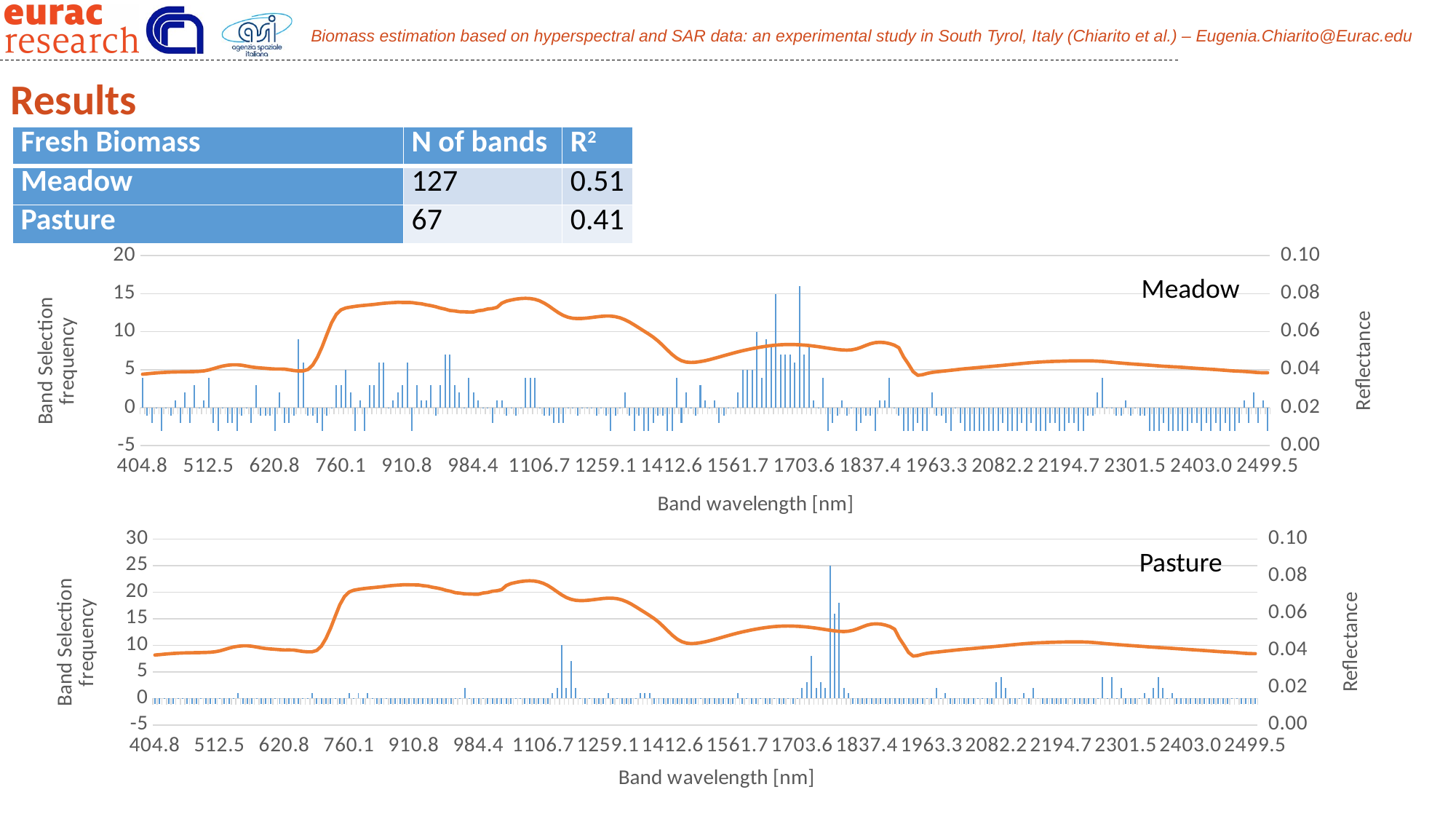
How many wavelength labels are shown along the x axis of the Meadow chart? 18 Which chart, Meadow or Pasture, has the higher maximum band selection frequency? Pasture How many charts are shown on the slide? 2 In the Meadow chart, is the highest band selection frequency bar greater or less than 10? greater What kind of chart is the Meadow chart? Combined bar and line chart What is the title of the right-hand vertical axis on the Meadow chart? Reflectance What is the x-axis title of the Pasture chart? Band wavelength [nm] In the Pasture chart, is the highest band selection frequency bar greater or less than 20? greater In the Pasture chart, is the reflectance at 910.8 nm greater or less than 0.06? greater In the Pasture chart, does the reflectance rise or fall between 620.8 nm and 760.1 nm? rise